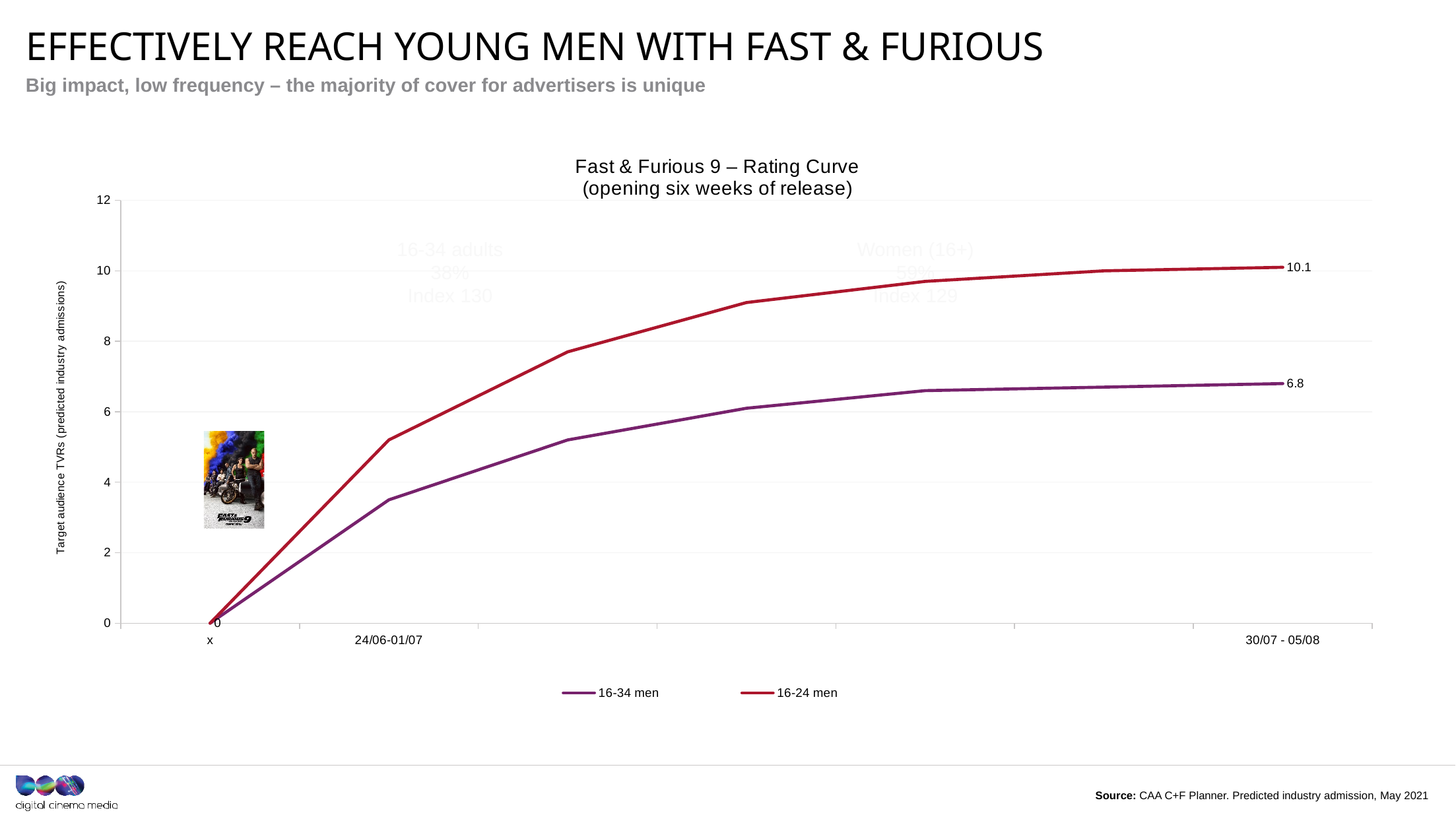
What is the starting value of both series at the first point on the x axis? 0 Is the value for 16-34 men at 24/06-01/07 greater or less than 4? less Which colour is used for the 16-24 men line? Red Do the values for 16-24 men rise or fall along the x axis? rise Is the value for 16-24 men at 24/06-01/07 greater or less than 4? greater What is the difference between the final values for 16-24 men and 16-34 men? 3.3 What is the title of the chart? Fast & Furious 9 – Rating Curve (opening six weeks of release) How many series does the legend list? 2 Which series reaches the higher value at the end of the period, 16-24 men or 16-34 men? 16-24 men What is the final value for 16-24 men at 30/07 - 05/08? 10.1 What kind of chart is shown on the slide? Line chart What is the final value for 16-34 men at 30/07 - 05/08? 6.8